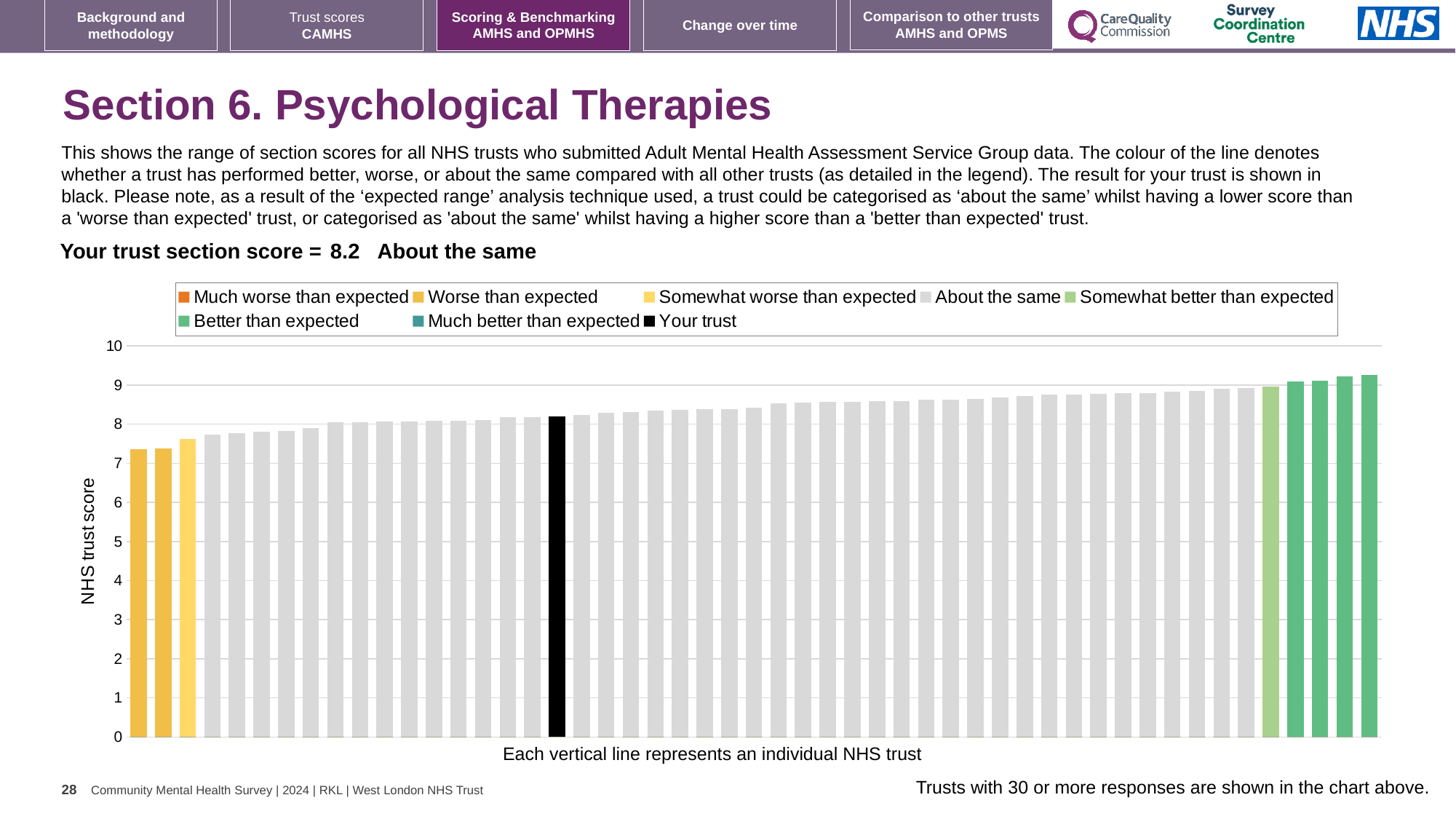
What colour is the bar representing your trust? black What is the section score for your trust shown on the slide? 8.2 Is the value of the highest bar in the chart greater or less than 9? greater What kind of chart is shown on the slide? bar chart Do the bar values rise or fall from left to right along the x axis? rise Which legend category do the highest bars on the right of the chart belong to? Better than expected Is the value of the lowest bar in the chart greater or less than 8? less What is the highest value shown on the vertical axis? 10 What is the label on the vertical axis of the chart? NHS trust score Which category is your trust placed in for this section? About the same How many entries does the chart legend list? 8 Is the value for your trust (the black bar) greater or less than 8? greater